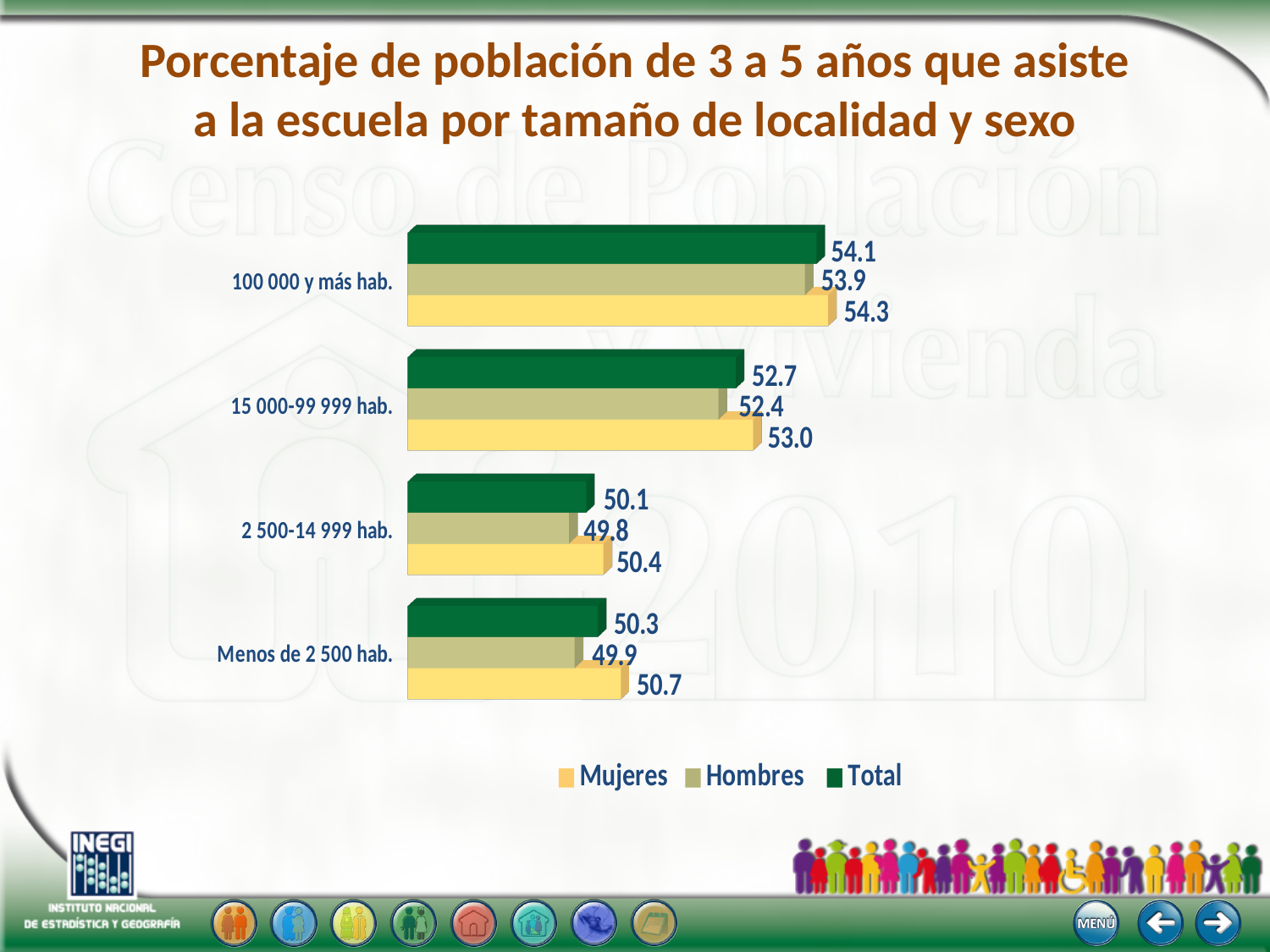
How many locality size categories are shown in the chart? 4 What kind of chart is shown on the slide? Bar chart Which locality size has the lowest Mujeres value? 2 500-14 999 hab. What is the Hombres value for 15 000-99 999 hab.? 52.4 What is the difference between the Mujeres and Hombres values for 100 000 y más hab.? 0.4 Which locality size has the highest Total value? 100 000 y más hab. How many series does the legend list? 3 Which series is shown in dark green in the legend? Total What is the Hombres value for 2 500-14 999 hab.? 49.8 What is the Total value for Menos de 2 500 hab.? 50.3 What is the Mujeres value for 100 000 y más hab.? 54.3 Which is larger for 15 000-99 999 hab., the Mujeres value or the Hombres value? Mujeres